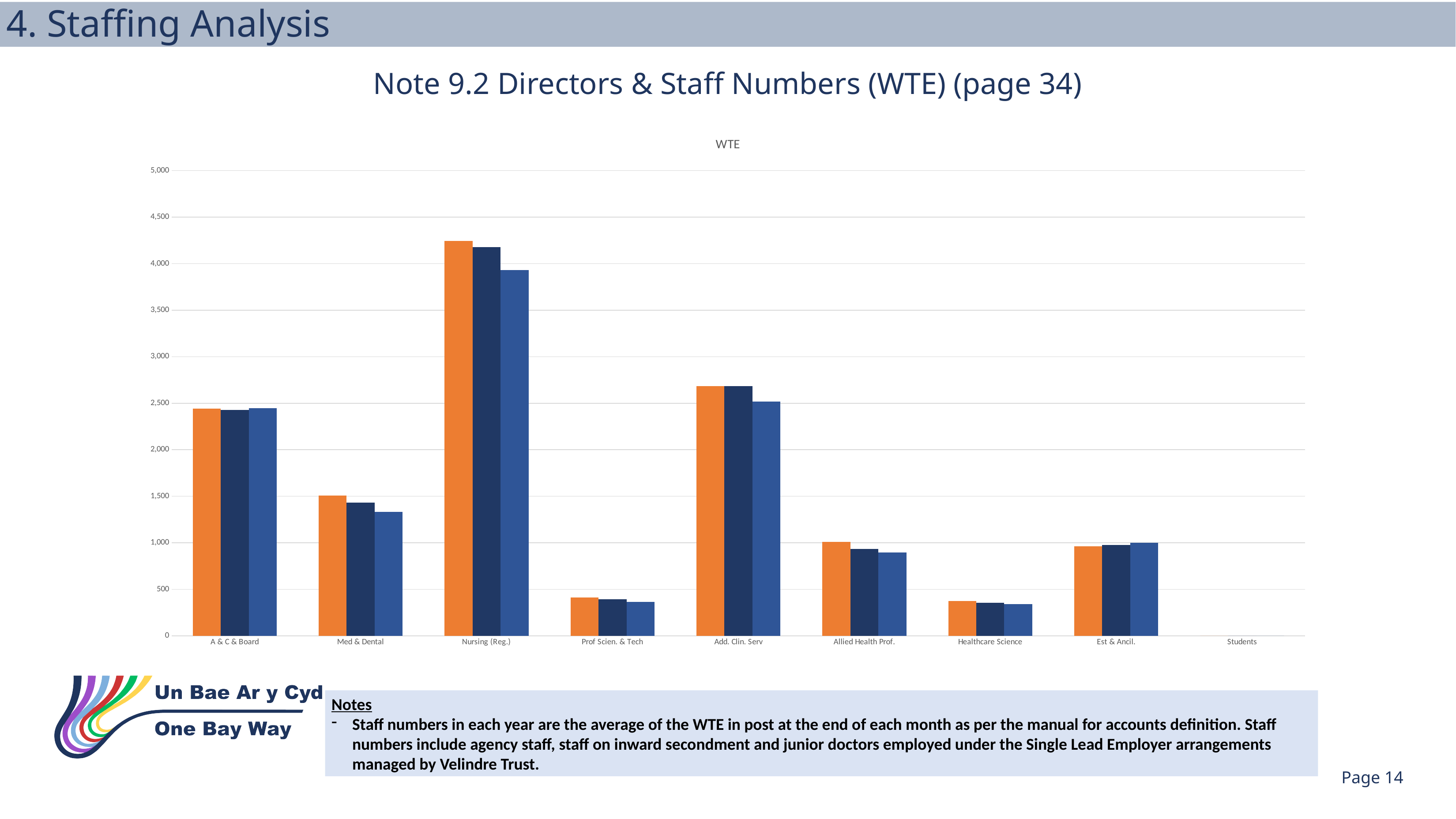
Which category has higher values, Nursing (Reg.) or Add. Clin. Serv? Nursing (Reg.) How many staff categories are listed along the x axis of the chart? 9 Is the value of the orange bar for Prof Scien. & Tech greater or less than 500? less Is the value of the orange bar for Add. Clin. Serv greater or less than 2,500? greater What is the title shown above the plot area of the chart? WTE Is the value of the orange bar for Nursing (Reg.) greater or less than 4,000? greater Which staff category has the tallest bars in the chart? Nursing (Reg.) Which category has higher values, Med & Dental or Allied Health Prof.? Med & Dental Do the three bars for Nursing (Reg.) rise or fall from left to right? fall What kind of chart is shown on the slide? bar chart Among the categories with visible bars, which has the lowest values? Healthcare Science